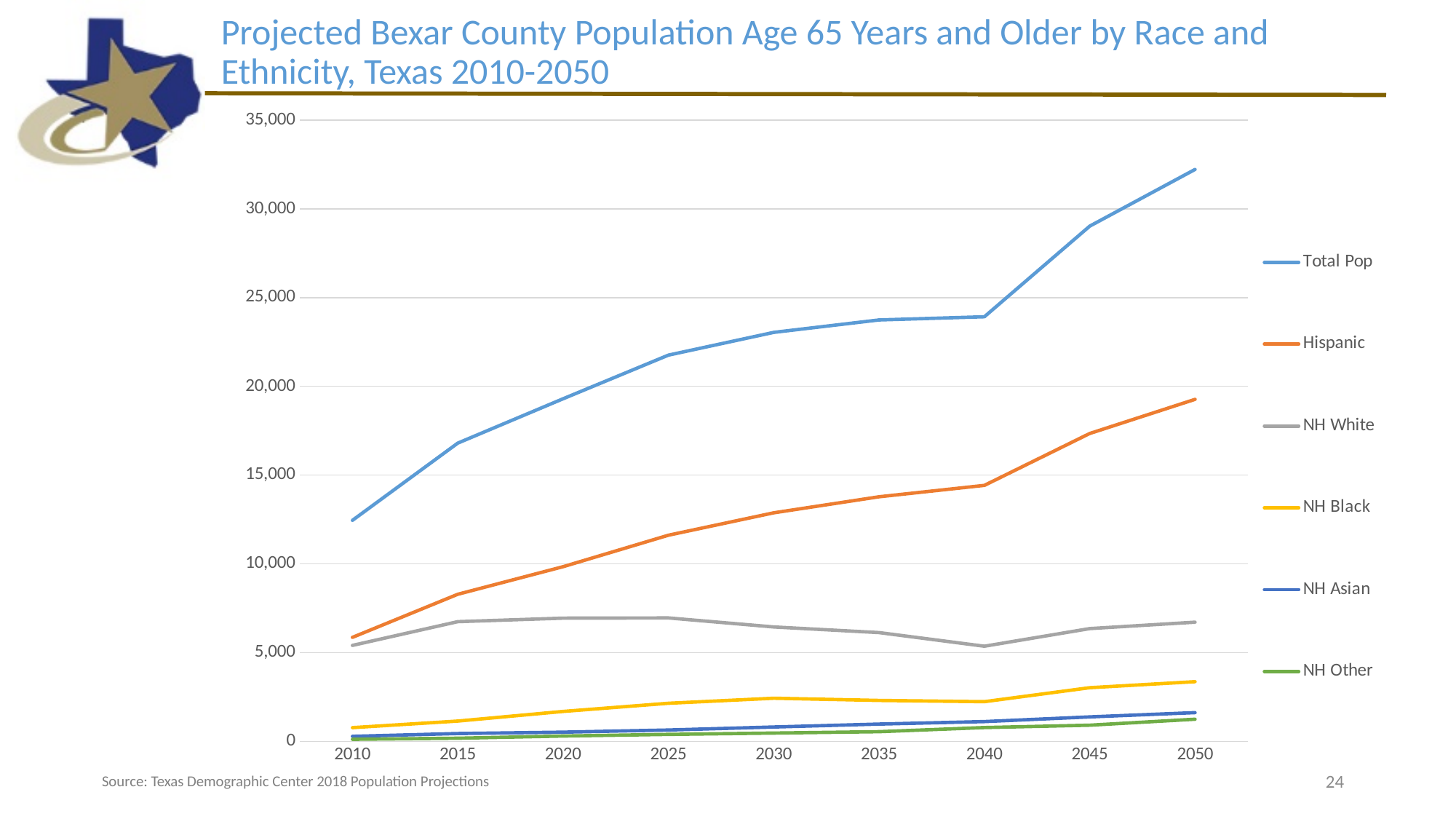
Does the Total Pop line rise or fall from 2010 to 2050? rise Which series has the lowest value in 2050? NH Other What kind of chart is shown on the slide? line chart Is the value for Total Pop in 2010 greater or less than 10,000? greater In 2050, which is larger: Hispanic or NH White? Hispanic Is the value for NH Black in 2050 greater or less than 5,000? less Is the value for Hispanic in 2050 greater or less than 15,000? greater How many series does the legend list? 6 Which series has the highest value in 2050? Total Pop Does the NH White line rise or fall between 2025 and 2040? fall How many years are plotted along the x axis? 9